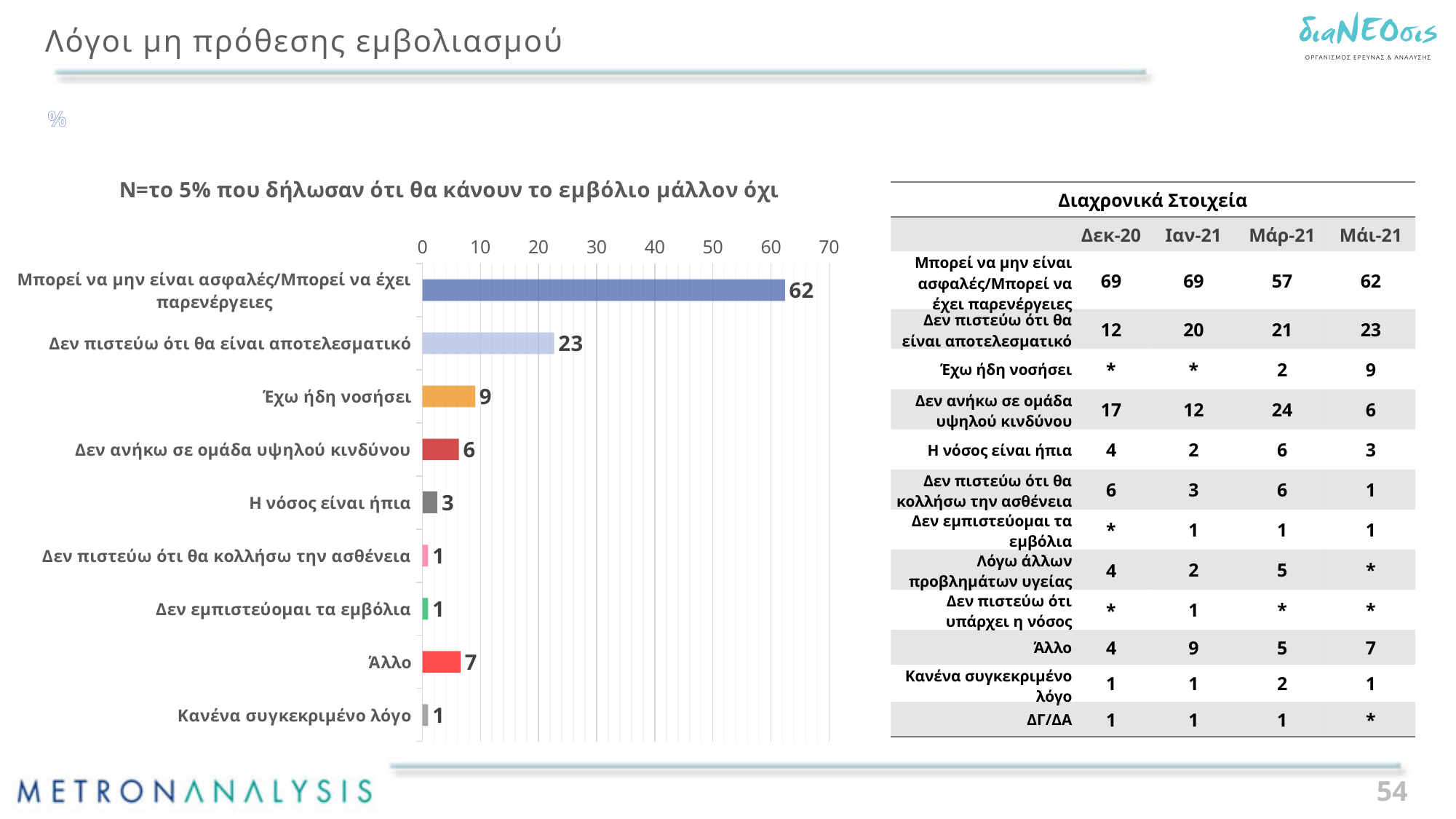
What is the title of the bar chart? N=το 5% που δήλωσαν ότι θα κάνουν το εμβόλιο μάλλον όχι What is the value for "Μπορεί να μην είναι ασφαλές/Μπορεί να έχει παρενέργειες" in the bar chart? 62 What is the value for "Δεν πιστεύω ότι θα είναι αποτελεσματικό" in the bar chart? 23 What is the value for "Έχω ήδη νοσήσει" in the bar chart? 9 Which category has the highest value in the bar chart? Μπορεί να μην είναι ασφαλές/Μπορεί να έχει παρενέργειες Is the value for "Δεν πιστεύω ότι θα είναι αποτελεσματικό" in the bar chart greater or less than 30? less What kind of chart is shown on the left of the slide? bar chart In the bar chart, which is larger: the value for "Άλλο" or the value for "Δεν ανήκω σε ομάδα υψηλού κινδύνου"? Άλλο What is the difference between the values for "Έχω ήδη νοσήσει" and "Δεν ανήκω σε ομάδα υψηλού κινδύνου" in the bar chart? 3 How many categories are shown in the bar chart? 9 What is the difference between the values for "Μπορεί να μην είναι ασφαλές/Μπορεί να έχει παρενέργειες" and "Δεν πιστεύω ότι θα είναι αποτελεσματικό" in the bar chart? 39 What is the value for "Άλλο" in the bar chart? 7